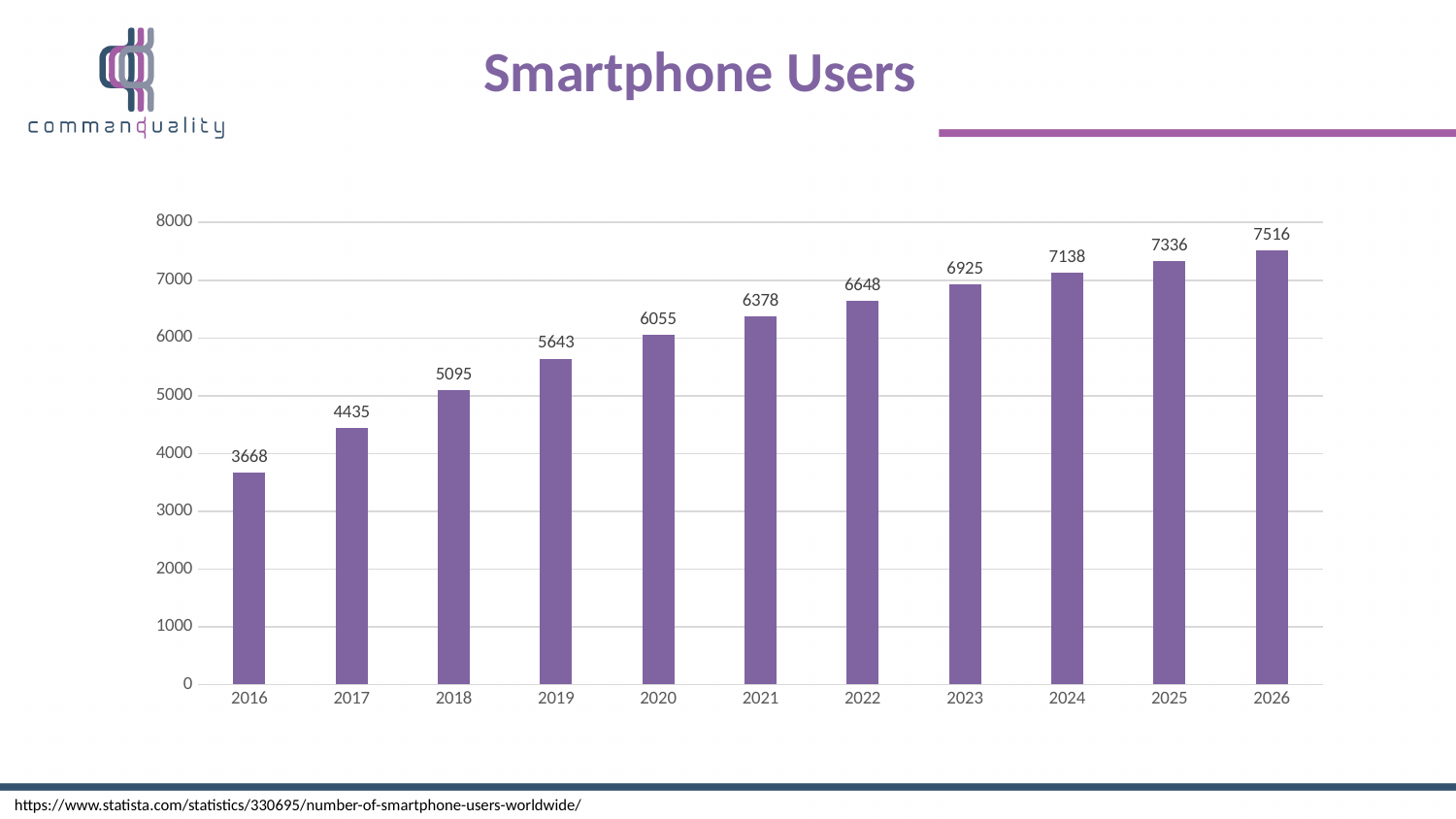
What kind of chart is shown on the slide? bar chart Is the value for 2023 greater or less than 7000? less What is the difference between the values for 2026 and 2016? 3848 Which year has the highest value? 2026 Do the values rise or fall from 2016 to 2026? rise How many years are shown on the x axis? 11 Which is larger, the value for 2021 or the value for 2022? 2022 Which year has the lowest value? 2016 What is the value for 2016? 3668 What is the value for 2020? 6055 What is the difference between the values for 2019 and 2018? 548 What is the value for 2024? 7138